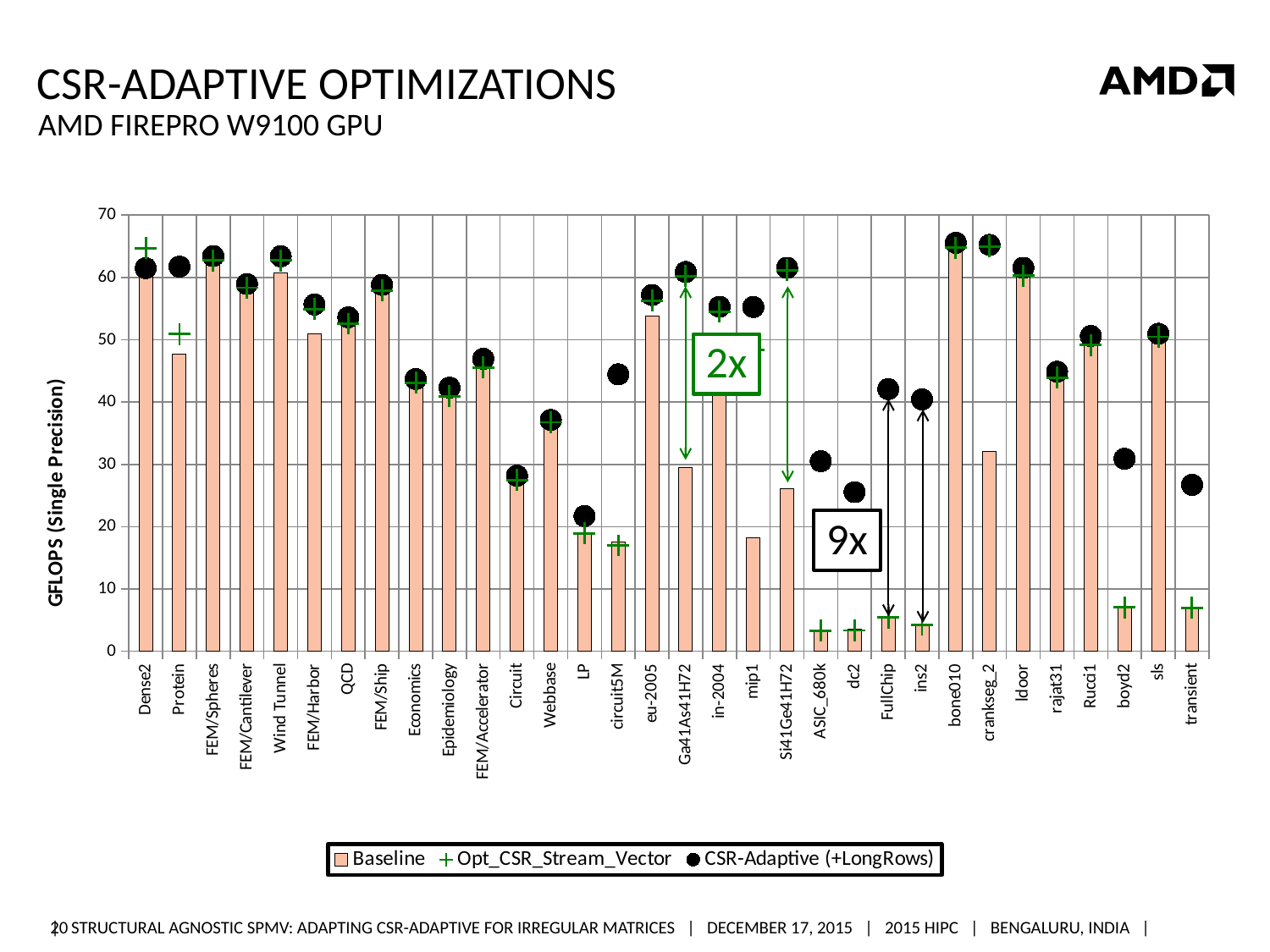
Is the Baseline value for Si41Ge41H72 greater or less than 30? less What kind of chart is shown on the slide? bar chart How many matrix categories are shown along the x axis? 32 Is the Baseline value for ASIC_680k greater or less than 10? less Which series is represented by the black circle markers in the legend? CSR-Adaptive (+LongRows) Is the CSR-Adaptive (+LongRows) value for bone010 greater or less than 60? greater What is the label on the y axis? GFLOPS (Single Precision) How many series does the legend list? 3 Which has the larger Baseline value, Dense2 or Protein? Dense2 Which has the larger Baseline value, FullChip or crankseg_2? crankseg_2